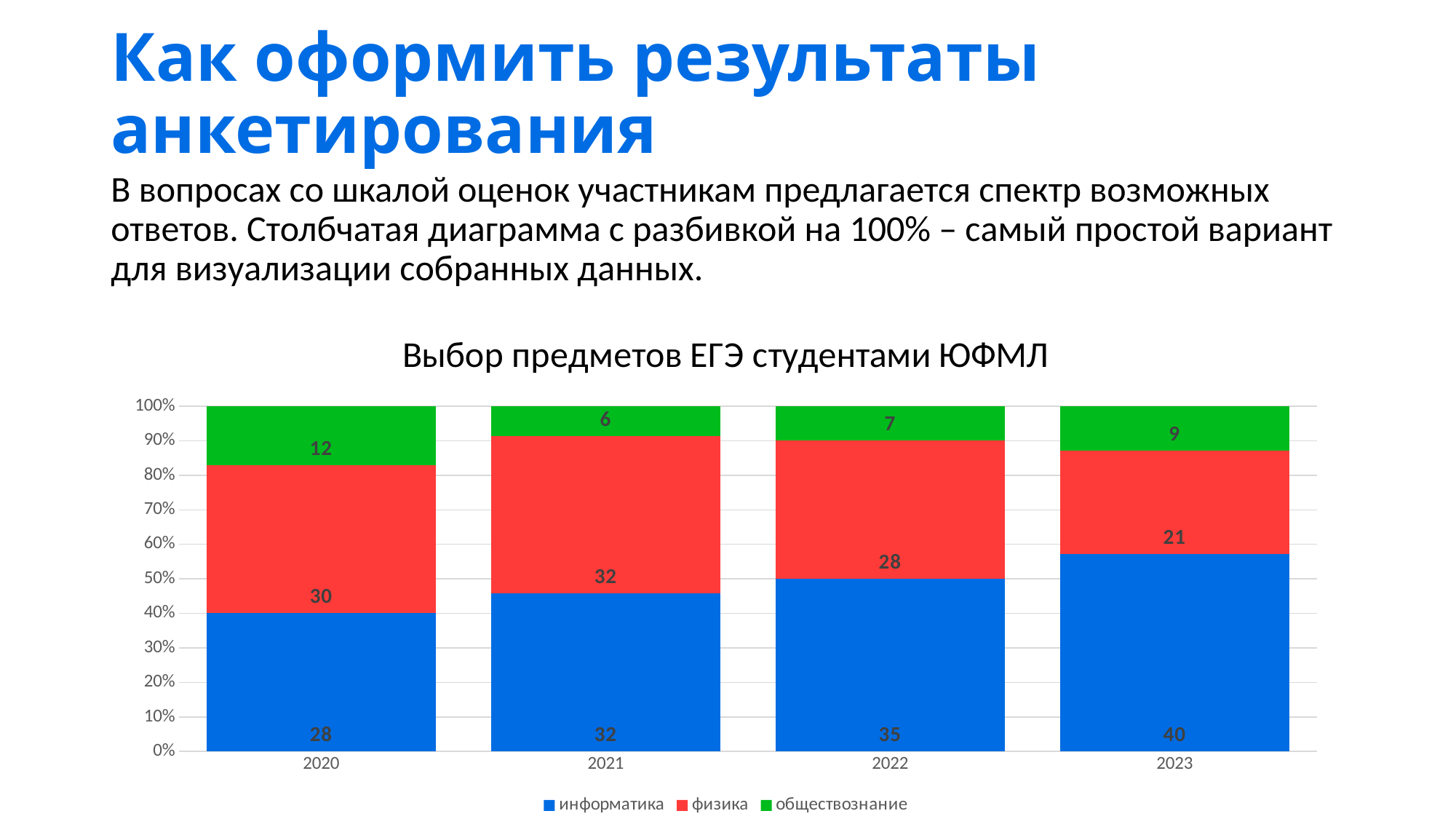
Which is larger: физика in 2021 or физика in 2023? физика in 2021 What kind of chart is shown? 100% stacked bar chart What is the value for обществознание in 2021? 6 In which year is the value for информатика highest? 2023 Do the values for информатика rise or fall from 2020 to 2023? rise How many years are shown on the x axis? 4 What is the difference between the информатика values for 2023 and 2020? 12 What is the value for информатика in 2023? 40 What is the value for физика in 2020? 30 In which year is the value for обществознание lowest? 2021 What is the total of the three data labels in the 2022 bar? 70 How many series does the legend list? 3